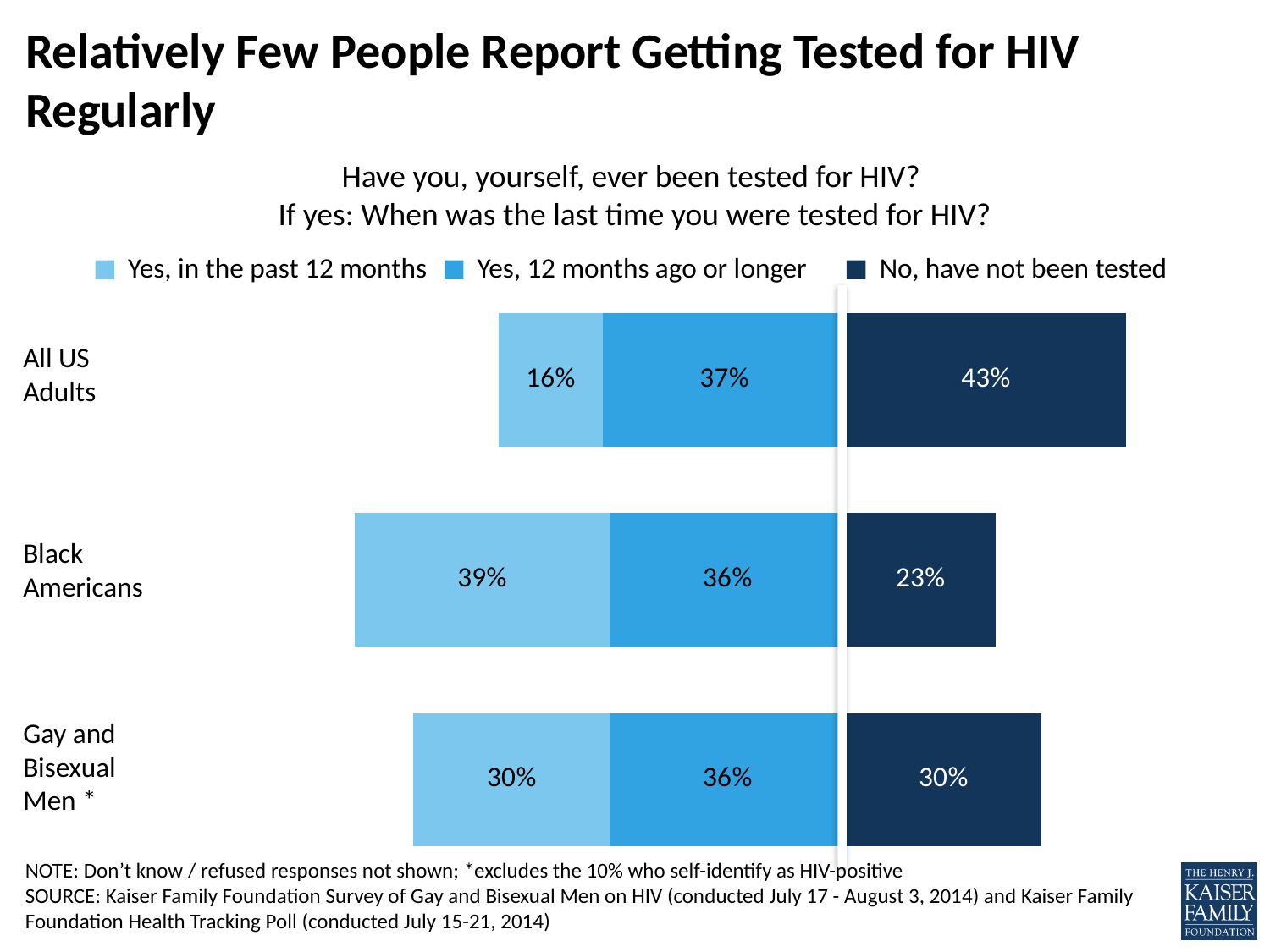
What is the difference between the share of Black Americans and the share of All US Adults tested in the past 12 months? 23 percentage points What kind of chart is shown on the slide? stacked bar chart Which group has the highest share saying they have not been tested for HIV? All US Adults What percentage of Gay and Bisexual Men were tested for HIV 12 months ago or longer? 36% How many groups are shown in the chart? 3 Is the share of Gay and Bisexual Men who have not been tested larger or smaller than the share of Black Americans who have not been tested? larger Which legend entry is shown in the darkest blue? No, have not been tested How many series does the legend list? 3 What is the total of the three labeled segments for Black Americans? 98% What percentage of Black Americans were tested for HIV in the past 12 months? 39% What percentage of All US Adults say they have not been tested for HIV? 43% Which group has the lowest share tested for HIV in the past 12 months? All US Adults